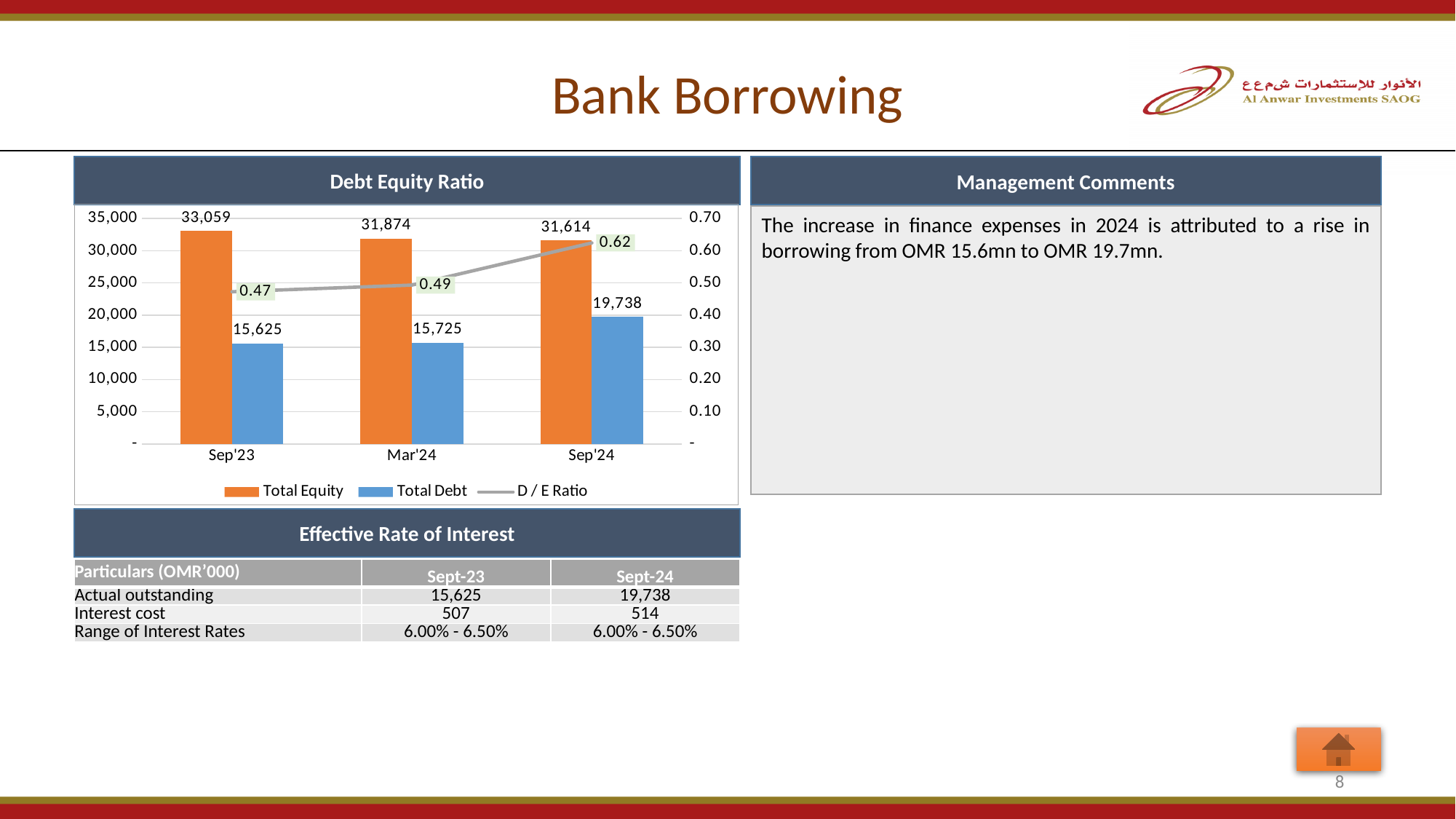
How many series does the legend of the Debt Equity Ratio chart list? 3 How many periods are shown on the x axis of the Debt Equity Ratio chart? 3 Which period has the highest Total Equity in the Debt Equity Ratio chart? Sep'23 What is the difference between Total Debt in Sep'24 and Total Debt in Mar'24 in the Debt Equity Ratio chart? 4,013 Is the Total Debt value for Sep'24 in the Debt Equity Ratio chart greater or less than 15,000? greater What colour are the Total Equity bars in the Debt Equity Ratio chart? Orange What is the Total Debt value for Sep'24 in the Debt Equity Ratio chart? 19,738 In the Debt Equity Ratio chart, is Total Equity for Mar'24 larger or smaller than Total Equity for Sep'24? larger What is the D / E Ratio for Mar'24 in the Debt Equity Ratio chart? 0.49 Does the D / E Ratio rise or fall from Sep'23 to Sep'24 in the Debt Equity Ratio chart? rise Which period has the lowest Total Debt in the Debt Equity Ratio chart? Sep'23 What is the Total Equity value for Sep'23 in the Debt Equity Ratio chart? 33,059